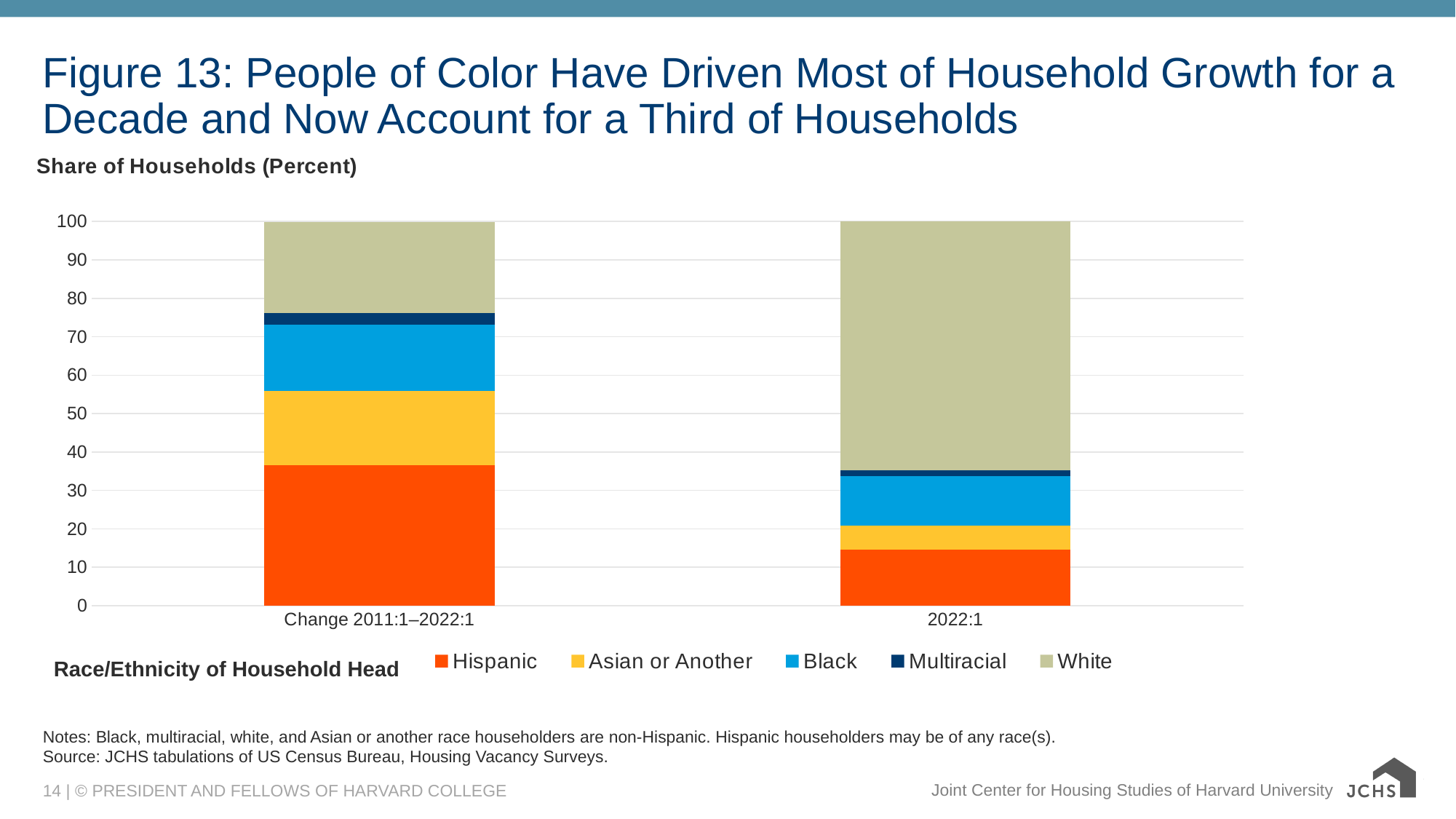
How many bars (categories) are shown on the x axis? 2 Is the Hispanic share in the Change 2011:1–2022:1 bar greater or less than 30? greater What is the label of the y axis (the units shown above the chart)? Share of Households (Percent) What kind of chart is shown on the slide? Stacked bar chart Which series is the smallest segment in the 2022:1 bar? Multiracial Is the White share in the 2022:1 bar greater or less than 50? greater Is the Hispanic share in the 2022:1 bar greater or less than 20? less What is the total height of the 2022:1 stacked bar? 100 Is the Hispanic segment larger in the Change 2011:1–2022:1 bar or in the 2022:1 bar? Change 2011:1–2022:1 Which series is the largest segment in the Change 2011:1–2022:1 bar? Hispanic Which series is the largest segment in the 2022:1 bar? White How many series does the legend list? 5